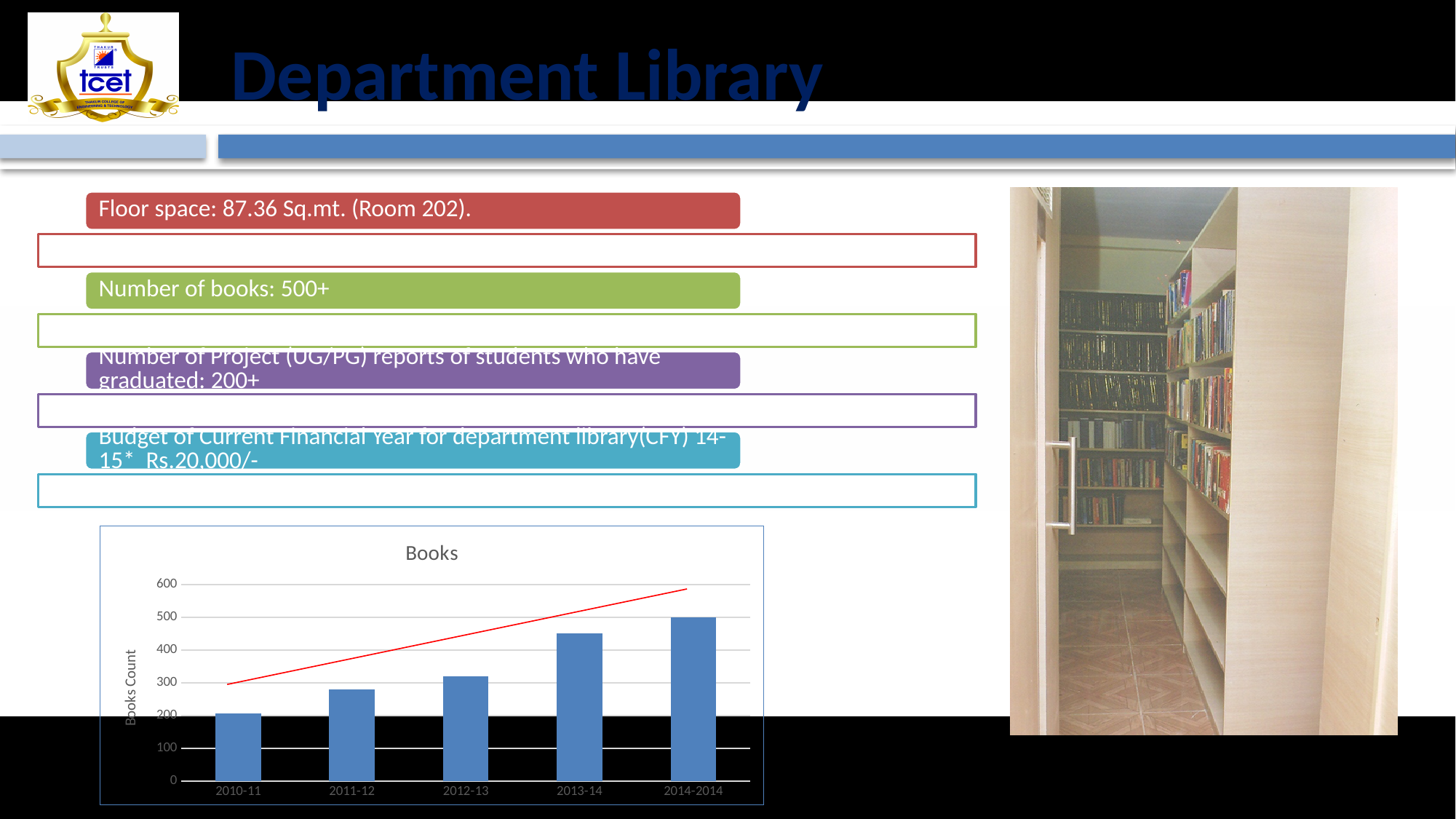
What kind of chart is shown on the slide? bar chart What is the title of the chart? Books Is the books count for 2011-12 greater or less than 300? less What is the books count for 2014-2014? 500 How many categories are shown on the x axis of the chart? 5 Which category has the lowest books count? 2010-11 Is the books count for 2013-14 greater or less than 400? greater Which has a larger books count, 2011-12 or 2013-14? 2013-14 What is the label on the vertical axis of the chart? Books Count Do the books count values rise or fall from 2010-11 to 2014-2014? rise Which category has the highest books count? 2014-2014 Is the books count for 2012-13 greater or less than 300? greater